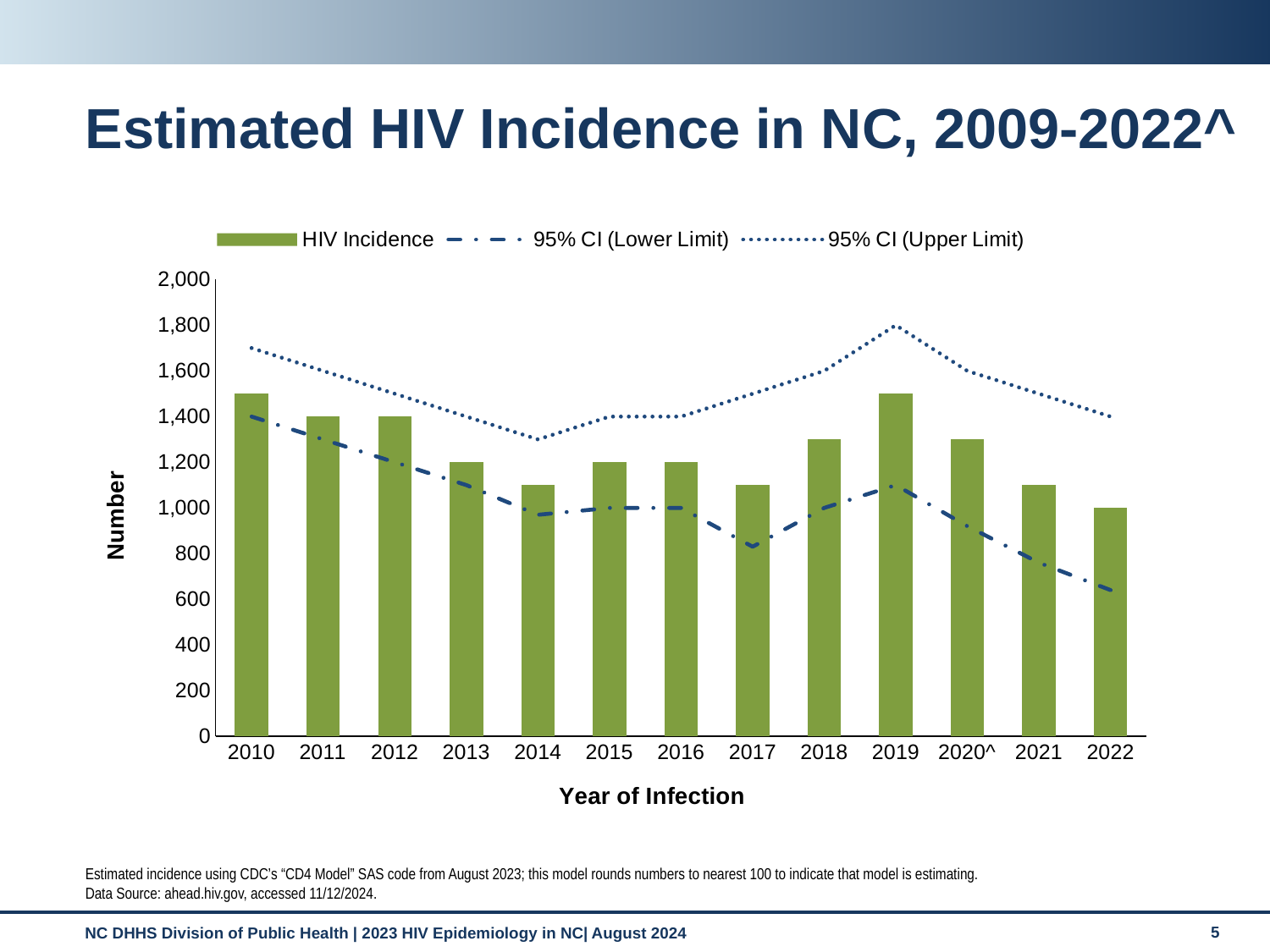
How many years are shown on the x axis? 13 Which year has the larger HIV Incidence bar, 2010 or 2022? 2010 Is the HIV Incidence value for 2010 greater or less than 1,400? greater Do the HIV Incidence bars rise or fall from 2019 to 2022? fall Is the HIV Incidence value for 2018 greater or less than 1,200? greater How many series does the legend list? 3 What is the HIV Incidence value for 2013? 1,200 What is the HIV Incidence value for 2022? 1,000 Is the HIV Incidence value for 2014 greater or less than 1,200? less What kind of chart is used to show HIV Incidence? bar chart What is the title of the chart? Estimated HIV Incidence in NC, 2009-2022^ Which year has the lowest HIV Incidence bar? 2022